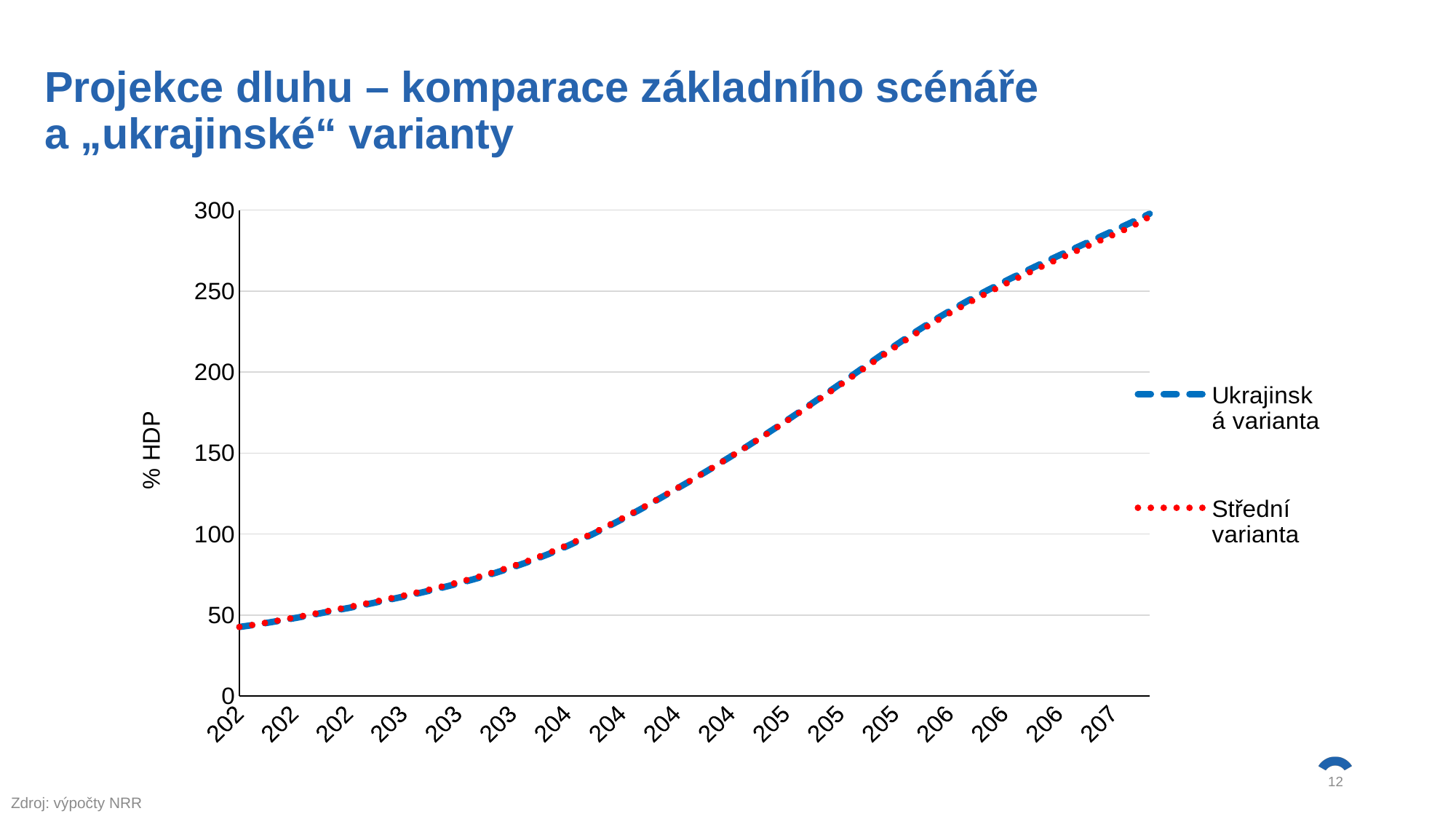
Is the first value of the Ukrajinská varianta series greater or less than 100? less Do the values of the Střední varianta series rise or fall along the x axis? rise Is the first value of the Střední varianta series greater or less than 50? less What is the label of the vertical axis? % HDP Which two series are listed in the legend? Ukrajinská varianta and Střední varianta Is the last value of the Střední varianta series greater or less than 200? greater What kind of chart is shown on the slide? line chart Do the values of the Ukrajinská varianta series rise or fall along the x axis? rise How many series does the legend list? 2